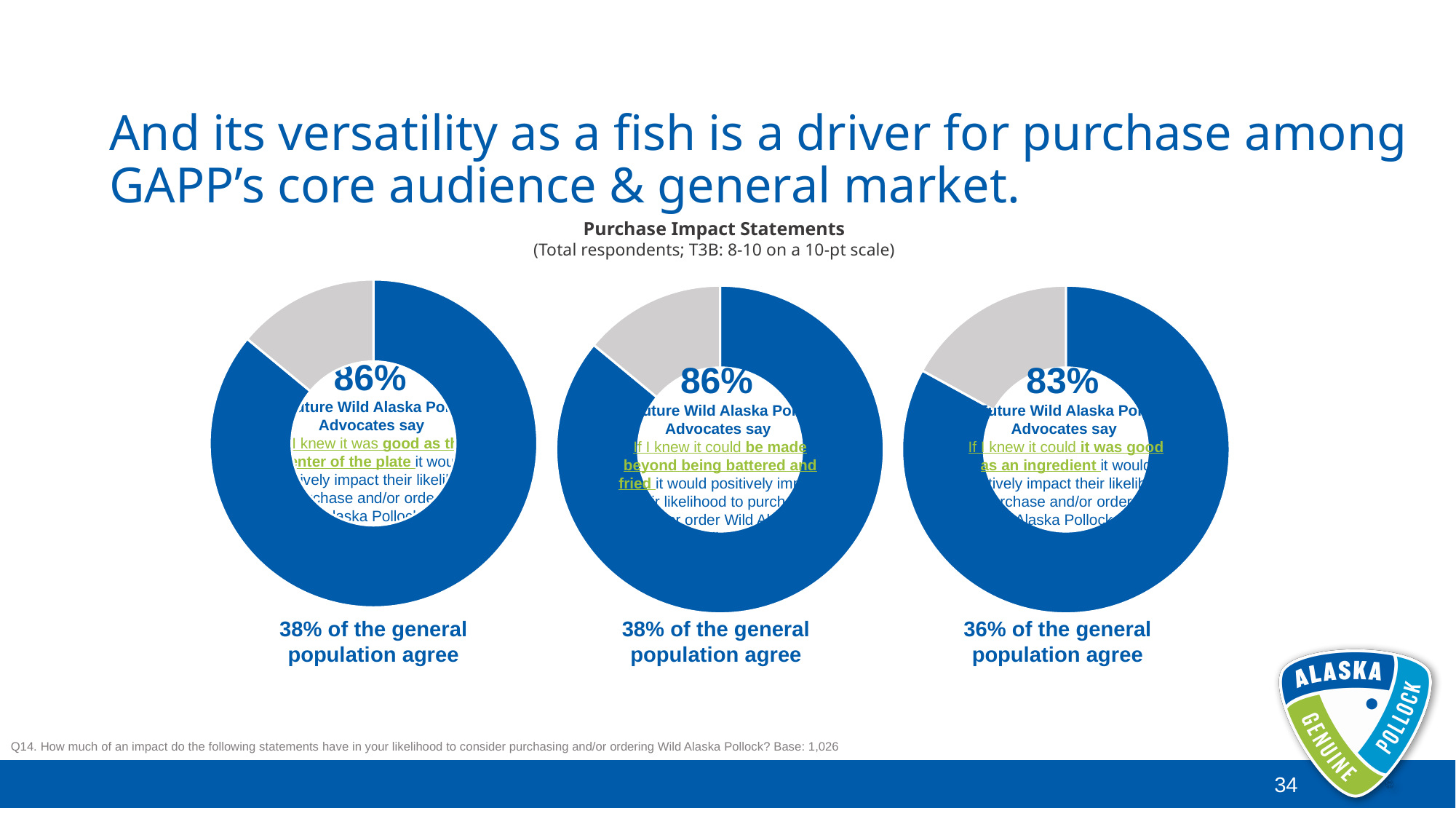
What is the title above the donut charts? Purchase Impact Statements In the middle donut chart (made beyond being battered and fried), what percentage is shown in the center? 86% What kind of chart is used on this slide? Donut (pie) chart How many donut charts are on the slide? 3 In the right donut chart (good as an ingredient), what percentage is shown in the center? 83% In the right donut chart, what share of the ring is the grey (non-agreeing) portion? 17% Which of the three donut charts shows the lowest percentage of Advocates agreeing? The right chart (good as an ingredient), 83% Is the percentage in the left donut chart larger or smaller than the percentage in the right donut chart? Larger In the left donut chart (good as the center of the plate), what percentage of Future Wild Alaska Pollock Advocates agree? 86% What is the difference between the percentage in the left donut chart and the percentage in the right donut chart? 3 percentage points Below the left donut chart, what percentage of the general population agree? 38% Below the right donut chart, what percentage of the general population agree? 36%